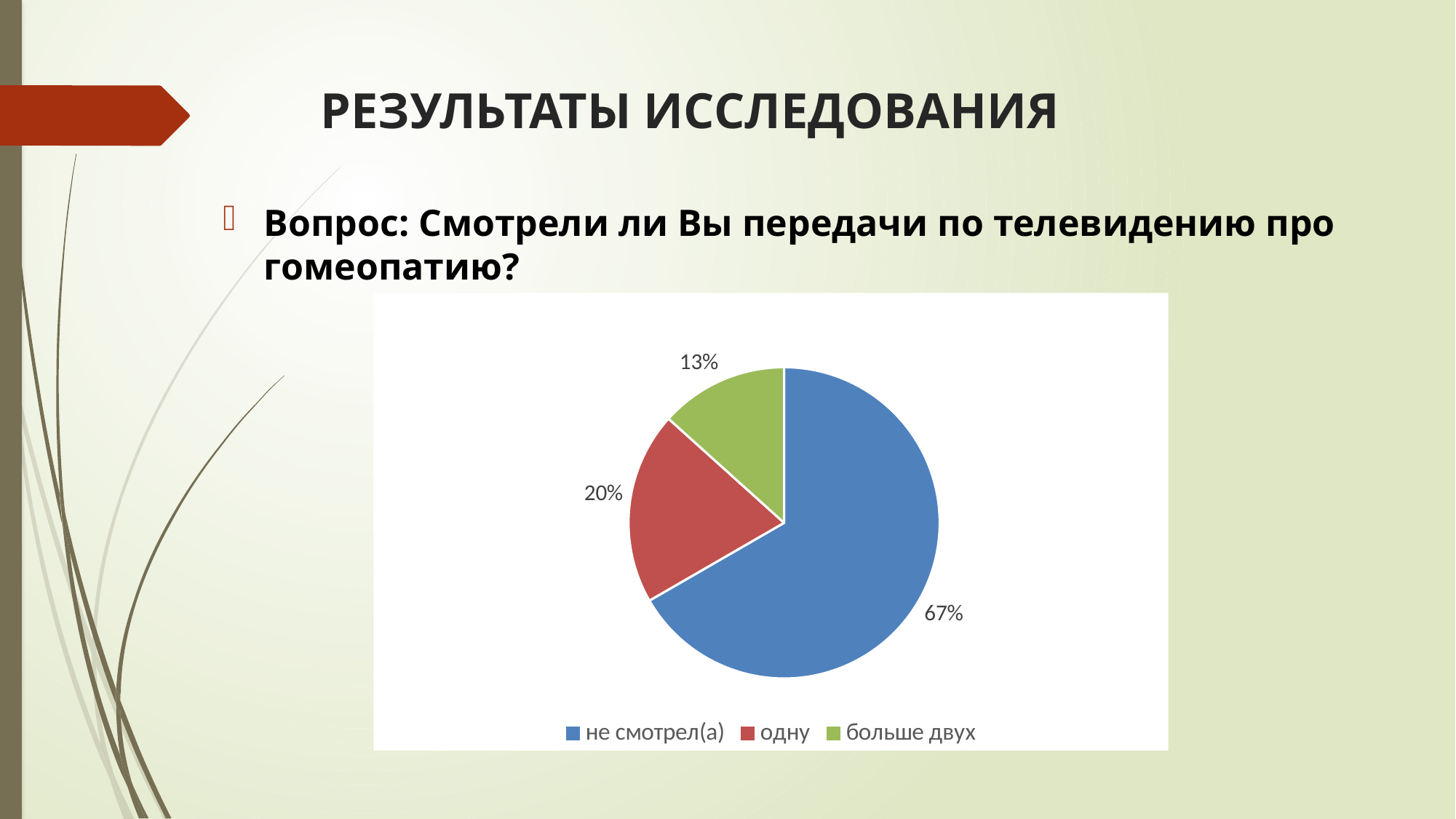
What kind of chart is shown on the slide? pie chart What share of the pie does the slice for "не смотрел(а)" represent? 67% Which category has the smallest slice of the pie? больше двух What colour is the slice for "одну"? red Which category has the largest slice of the pie? не смотрел(а) What is the difference in percentage points between the "одну" slice and the "больше двух" slice? 7 Which category is shown in blue in the legend? не смотрел(а) Which slice is larger, "одну" or "больше двух"? одну What share of the pie does the slice for "одну" represent? 20% How many categories does the pie chart show? 3 What share of the pie does the slice for "больше двух" represent? 13% What is the difference in percentage points between the "не смотрел(а)" slice and the "одну" slice? 47